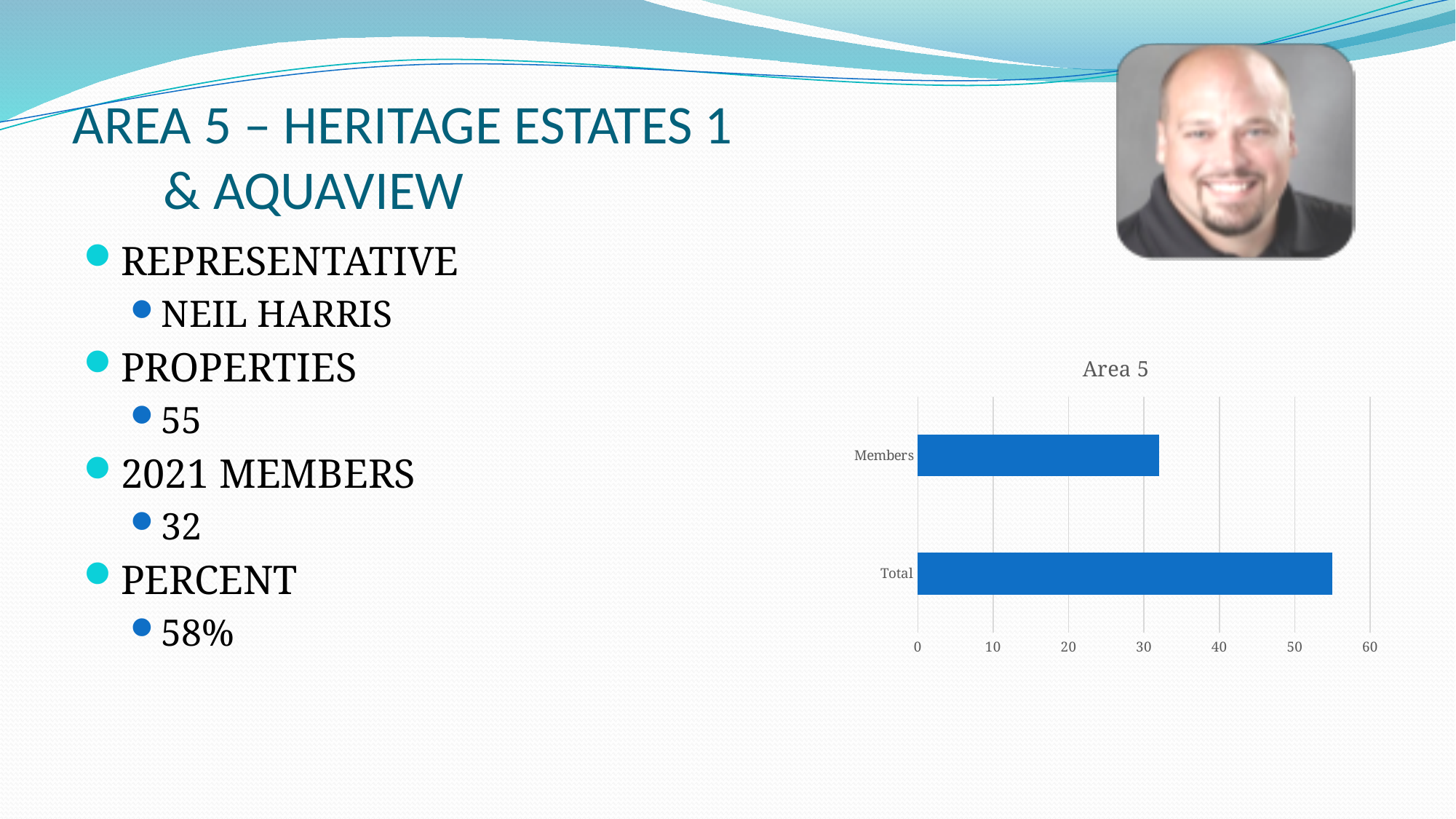
Is the value for Total greater or less than 50? greater Which is larger in the chart, Members or Total? Total How many categories does the chart show? 2 Which category has the shortest bar in the chart? Members Is the value for Members greater or less than 30? greater What is the title of the chart? Area 5 Is the value for Members greater or less than 40? less What kind of chart is shown on the slide? bar chart What is the highest value shown on the chart's horizontal axis? 60 Which category has the longest bar in the chart? Total